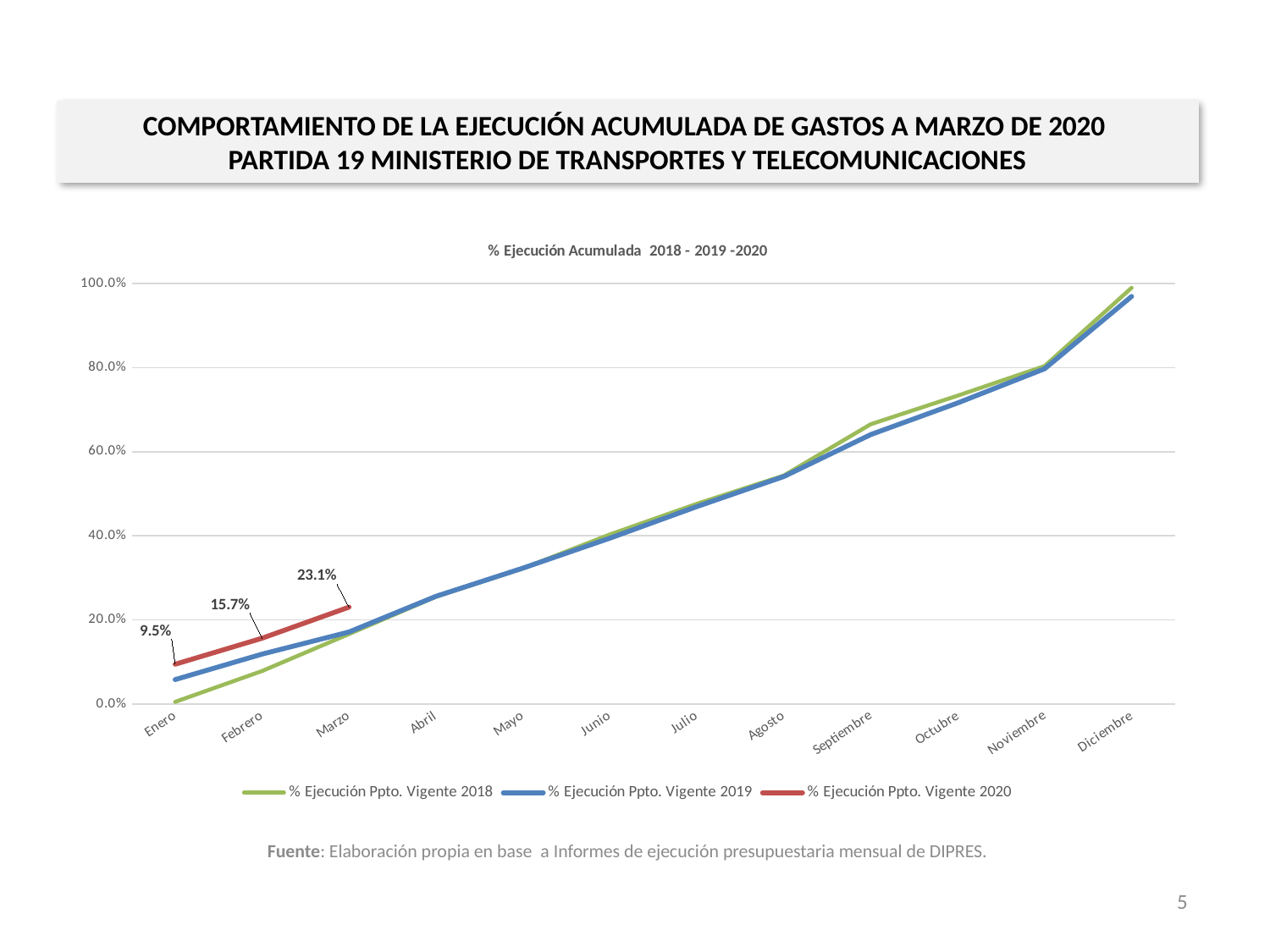
What is the difference between the Marzo and Enero values of % Ejecución Ppto. Vigente 2020? 13.6% Do the values for % Ejecución Ppto. Vigente 2018 rise or fall from Enero to Diciembre? Rise How many series does the legend list? 3 Is the value for % Ejecución Ppto. Vigente 2018 in Diciembre greater or less than 80.0%? greater What is the title of the chart? % Ejecución Acumulada 2018 - 2019 -2020 How many months are shown on the x axis? 12 What kind of chart is shown on the slide? Line chart What is the value for % Ejecución Ppto. Vigente 2020 in Febrero? 15.7% What is the difference between the Marzo and Febrero values of % Ejecución Ppto. Vigente 2020? 7.4% In Marzo, which series has the larger value: % Ejecución Ppto. Vigente 2020 or % Ejecución Ppto. Vigente 2019? % Ejecución Ppto. Vigente 2020 What is the value for % Ejecución Ppto. Vigente 2020 in Enero? 9.5% What is the value for % Ejecución Ppto. Vigente 2020 in Marzo? 23.1%